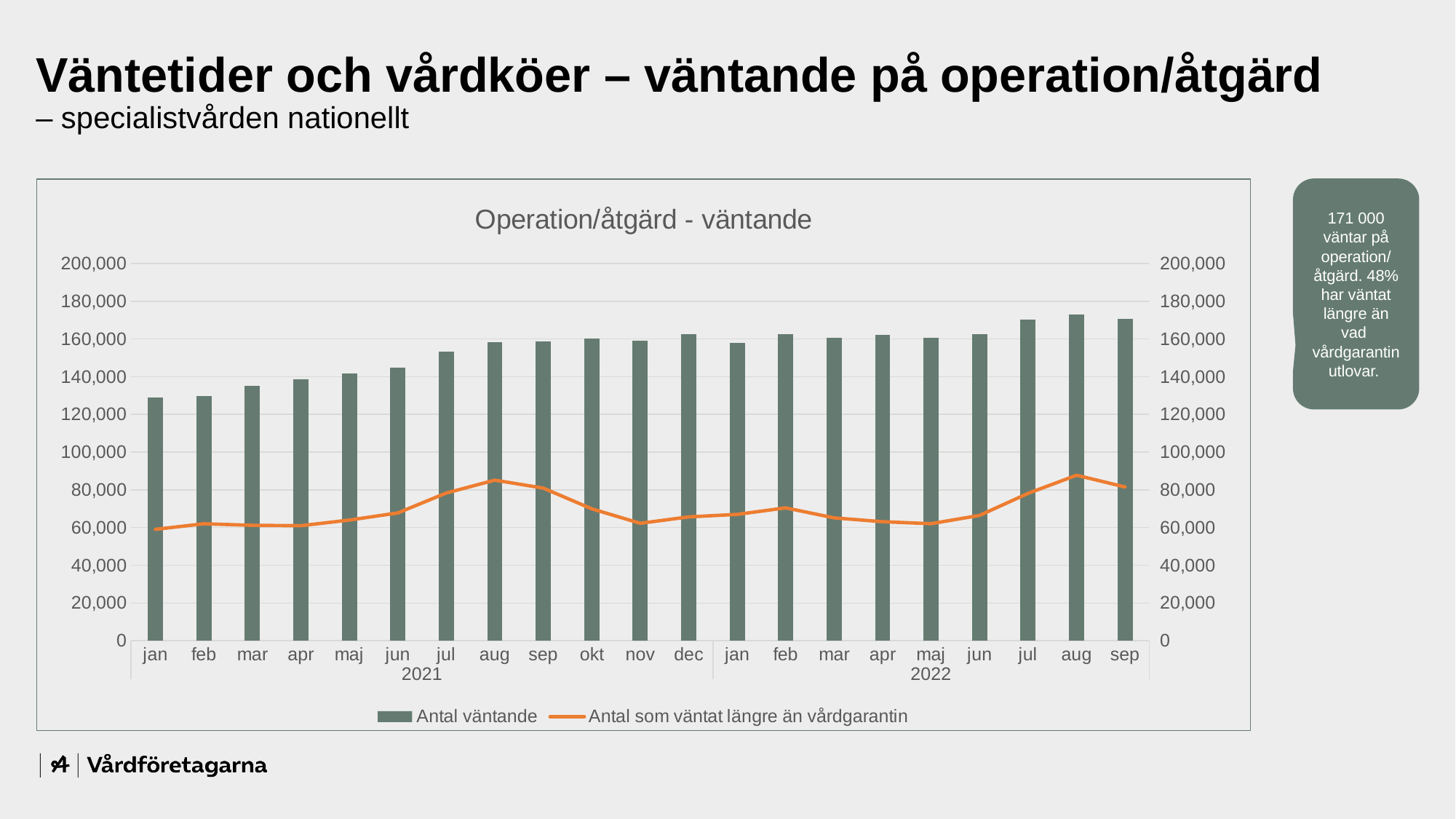
How many series does the legend list? 2 Which is larger, the Antal väntande bar for jan 2021 or for dec 2021? dec 2021 Is the Antal väntande bar for aug 2021 greater or less than 140,000? greater Which series is drawn as an orange line? Antal som väntat längre än vårdgarantin What kind of chart is shown on the slide? A combined bar and line chart Which month has the lowest bar for Antal väntande? jan 2021 What is the title of the chart? Operation/åtgärd - väntande Is the value of Antal som väntat längre än vårdgarantin for nov 2021 greater or less than 80,000? less How many months are plotted along the x axis? 21 Do the Antal väntande bars generally rise or fall from jan 2021 to sep 2022? rise Is the Antal väntande bar for aug 2022 greater or less than 160,000? greater